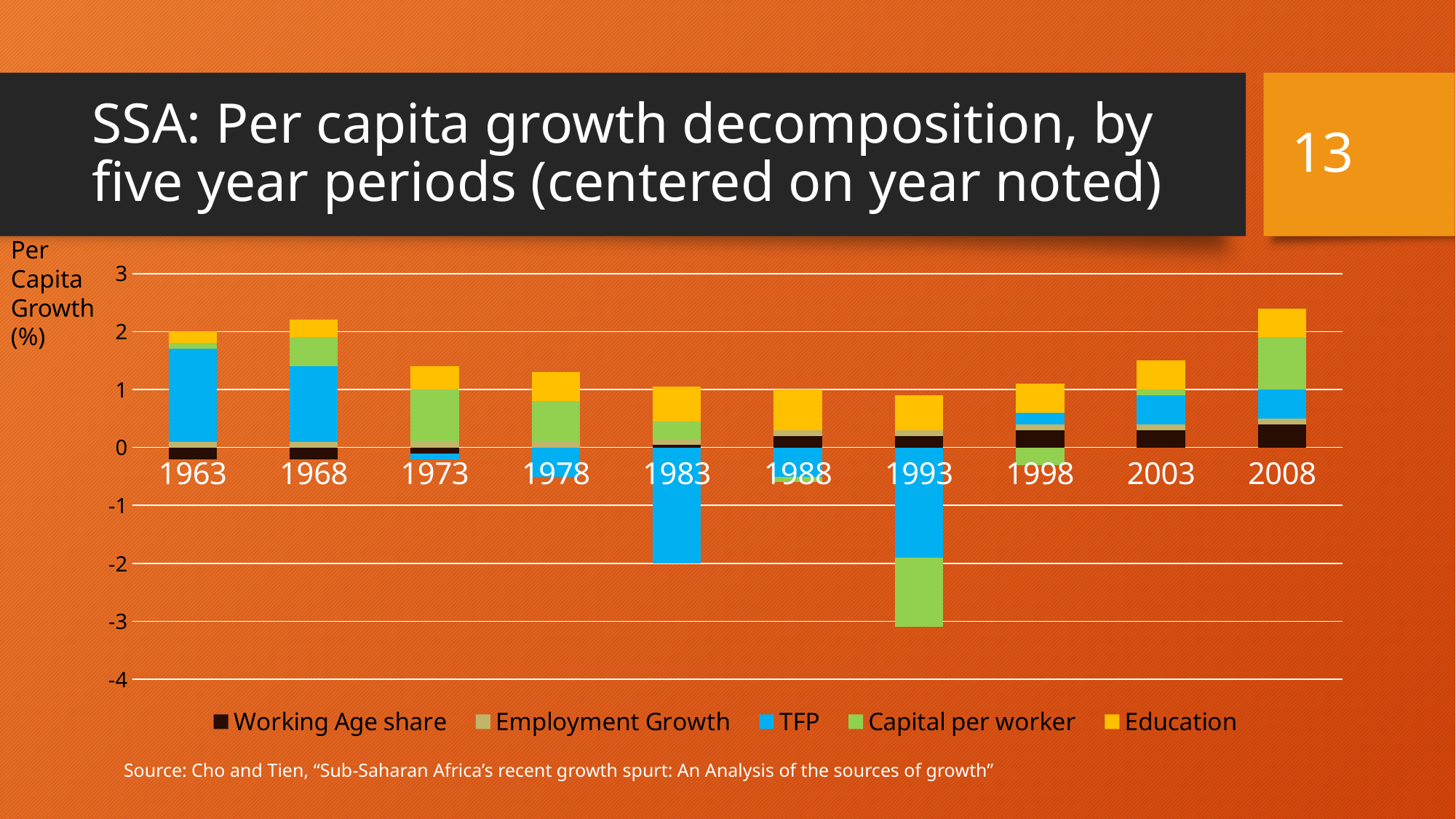
Is the bottom of the stacked bar for 1993 greater or less than -2? less Which year's bar extends further below zero, 1983 or 1988? 1983 Which year's bar extends furthest below zero? 1993 Is the bottom of the stacked bar for 1983 greater or less than -1? less What kind of chart is shown on the slide? Stacked bar chart Is the top of the stacked bar for 2008 greater or less than 2? greater Which series in the legend is shown in blue? TFP How many five-year periods (years) are shown on the x axis of the chart? 10 What is the label on the vertical axis of the chart? Per Capita Growth (%) Which year has the taller positive stack, 2008 or 1998? 2008 How many series does the chart's legend list? 5